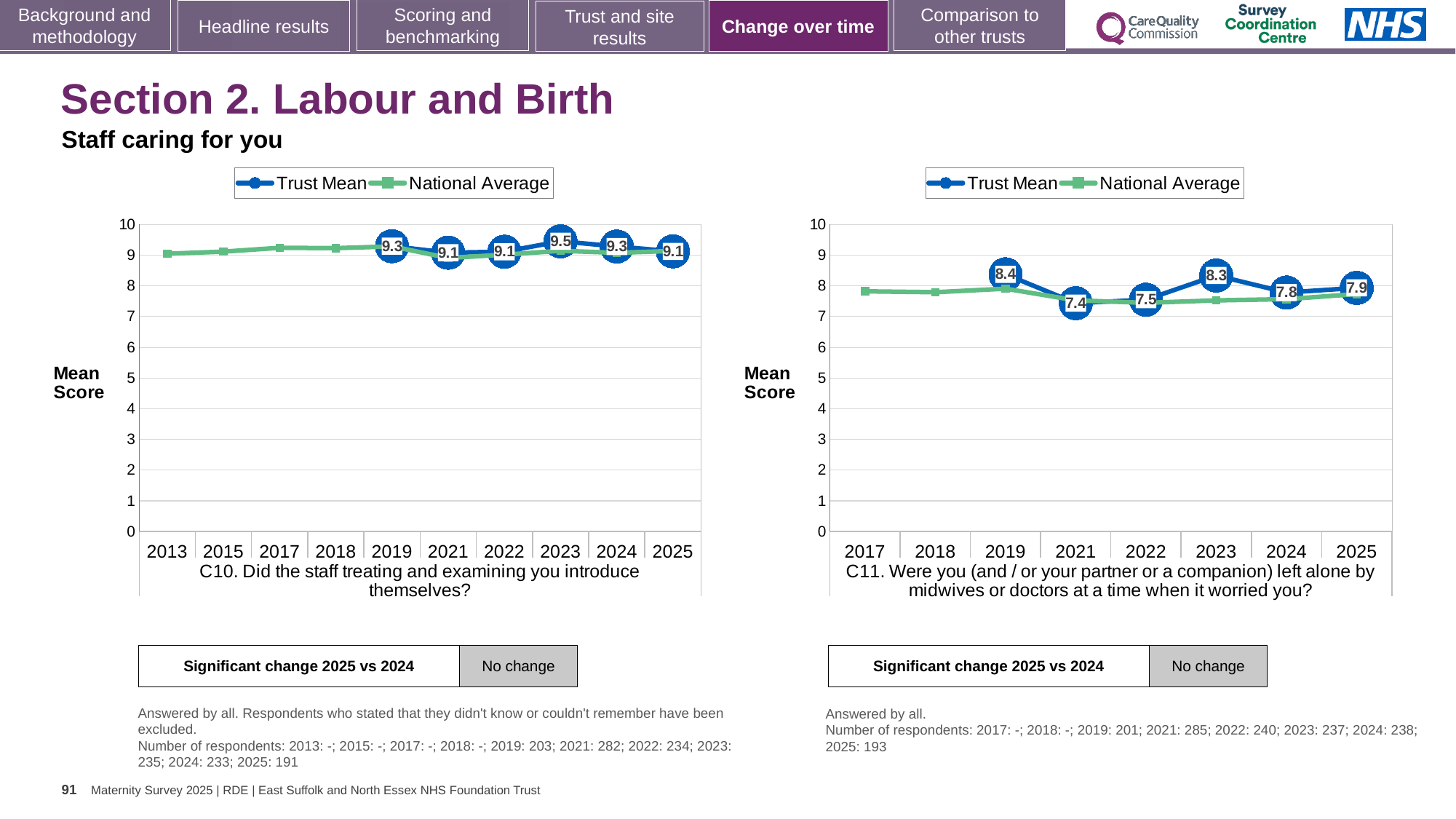
What type of chart is the left chart (C10)? Line chart How many series does the legend of the right chart (C11) list? 2 In the left chart (C10), which year has the highest Trust Mean score? 2023 In the right chart (C11), is the National Average for 2025 greater or less than 8? less In the right chart (C11), what is the difference between the Trust Mean scores for 2019 and 2021? 1.0 In the right chart (C11), is the Trust Mean score for 2023 or 2024 higher? 2023 In the left chart (C10), what is the Trust Mean score for 2025? 9.1 In the left chart (C10), what is the difference between the Trust Mean scores for 2023 and 2025? 0.4 In the left chart (C10), how many years are shown on the x axis? 10 In the right chart (C11), which year has the lowest Trust Mean score? 2021 In the left chart (C10), what is the Trust Mean score for 2023? 9.5 In the right chart (C11), what is the Trust Mean score for 2019? 8.4